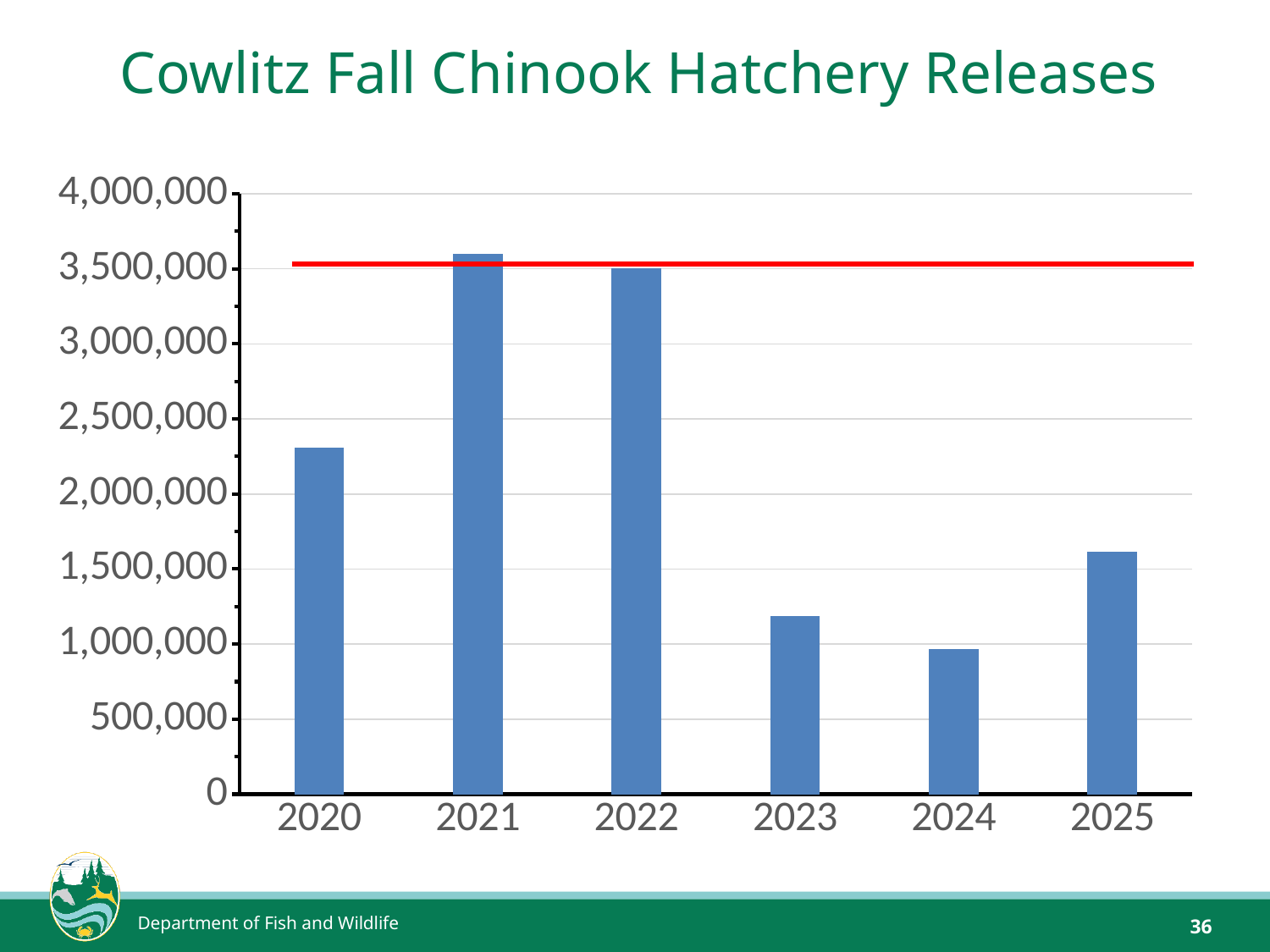
Which year has the lowest hatchery releases? 2024 Is the value for 2023 greater or less than 1,000,000? greater How many years are plotted on the x axis? 6 Is the value for 2025 greater or less than 1,500,000? greater Which year has the larger value, 2020 or 2025? 2020 Do the values rise or fall from 2022 to 2024? fall Is the value for 2021 greater or less than 3,500,000? greater What kind of chart is shown on the slide? bar chart What is the title of the chart? Cowlitz Fall Chinook Hatchery Releases Which year has the highest hatchery releases? 2021